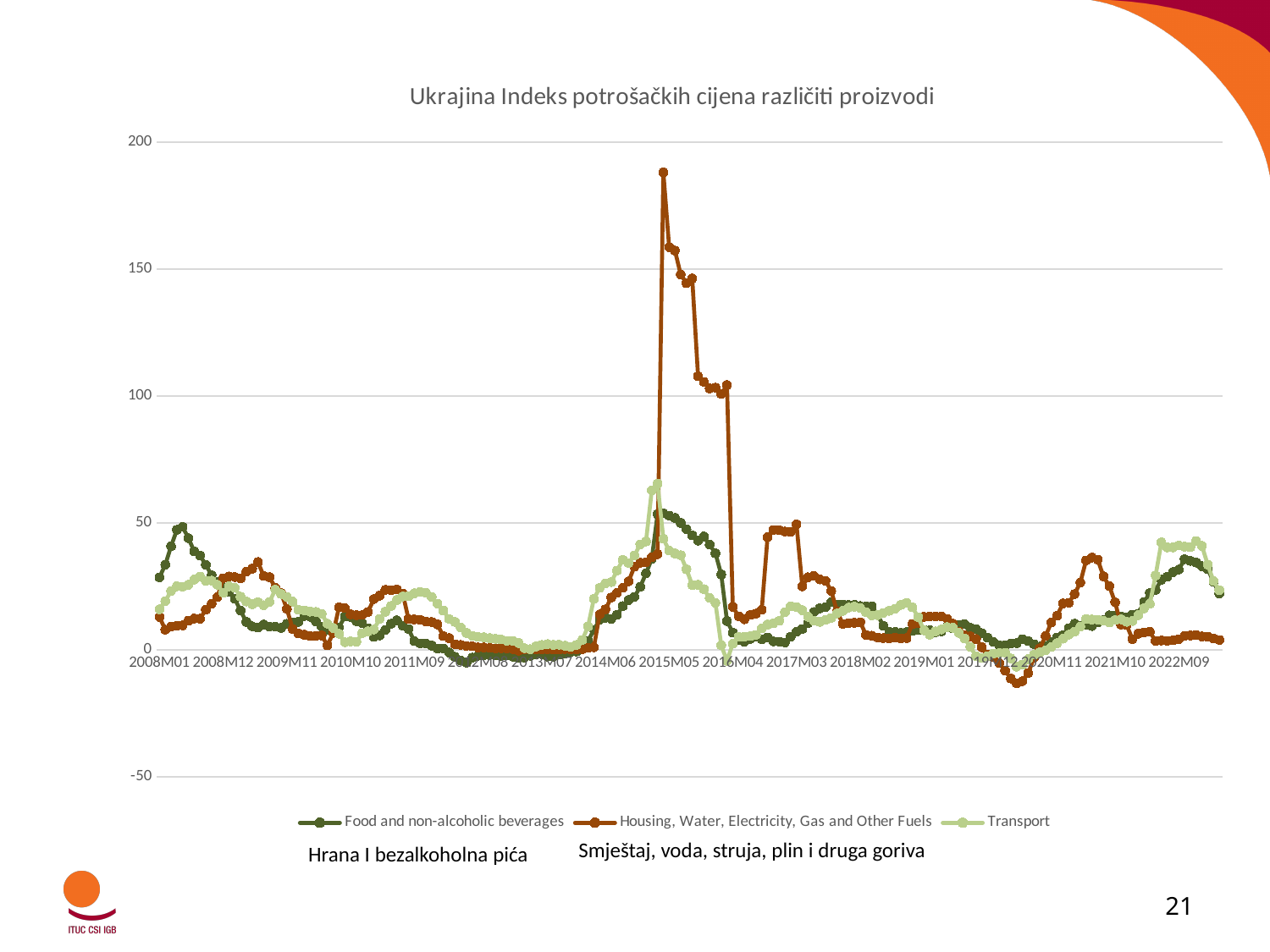
How many series does the legend list? 3 Is the peak value of the Transport series around 2015 greater or less than 50? greater Around 2015M05, which series is higher: Housing, Water, Electricity, Gas and Other Fuels or Food and non-alcoholic beverages? Housing, Water, Electricity, Gas and Other Fuels Which series is labelled 'Transport' in the legend? the light green line Is the peak value of the Housing, Water, Electricity, Gas and Other Fuels series greater or less than 150? greater Is the value of the Food and non-alcoholic beverages series at 2013M07 greater or less than 50? less What is the highest value shown on the y axis? 200 Which series reaches the highest value anywhere on the chart? Housing, Water, Electricity, Gas and Other Fuels How many date labels are shown on the x axis? 17 Around 2022M09, which series is higher: Transport or Housing, Water, Electricity, Gas and Other Fuels? Transport What kind of chart is shown on the slide? line chart What is the title of the chart? Ukrajina Indeks potrošačkih cijena različiti proizvodi